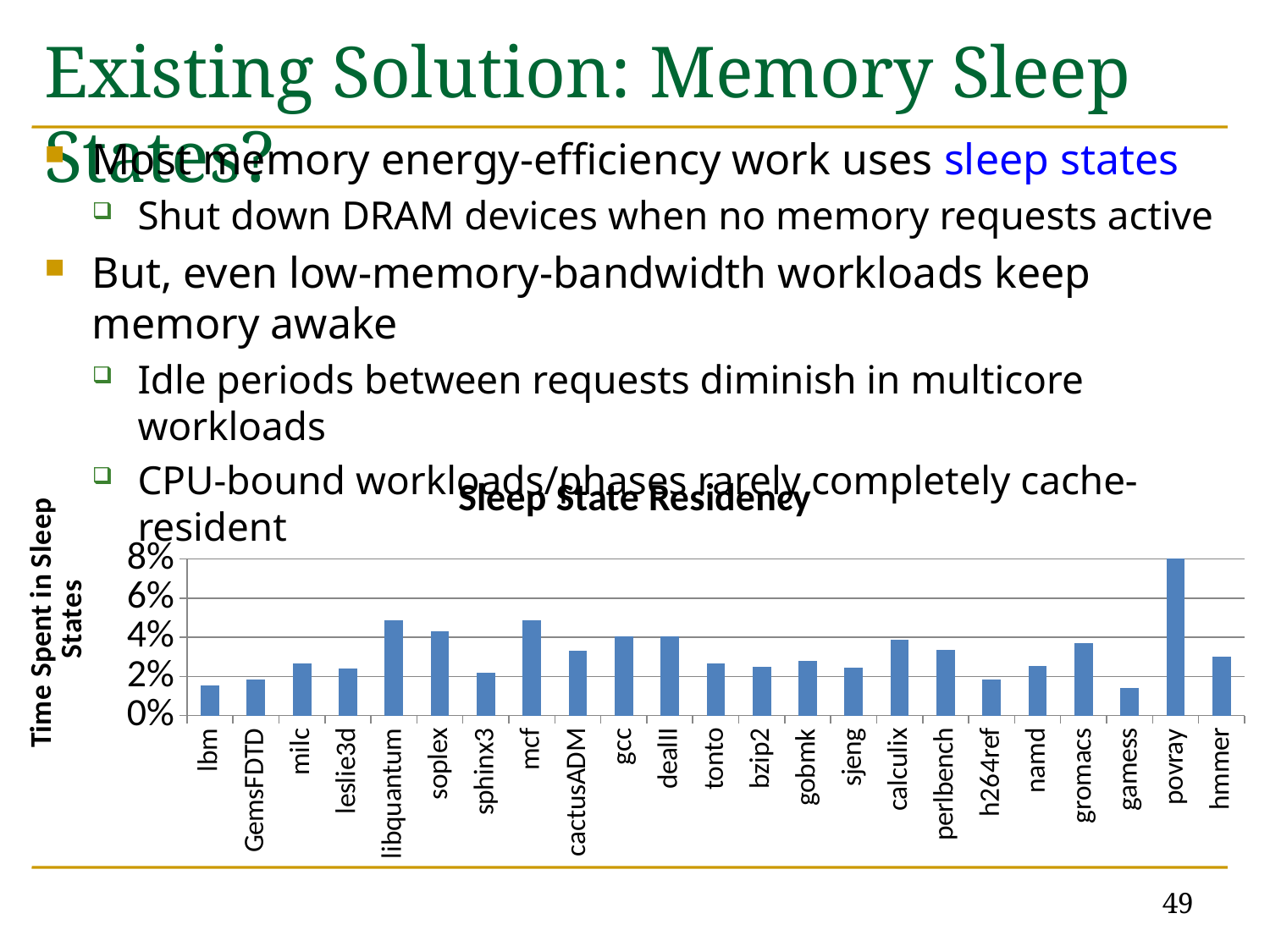
Is the value for sphinx3 greater or less than 4%? less How many workloads (categories) are plotted in the Sleep State Residency chart? 23 Which has a larger value, mcf or tonto? mcf Is the value for povray greater or less than 6%? greater What is the title of the chart on the slide? Sleep State Residency Is the value for gamess greater or less than 2%? less What is the label on the vertical axis of the chart? Time Spent in Sleep States Which workload has the highest time spent in sleep states in the chart? povray What kind of chart is shown on the slide? bar chart Which has a larger value, povray or hmmer? povray